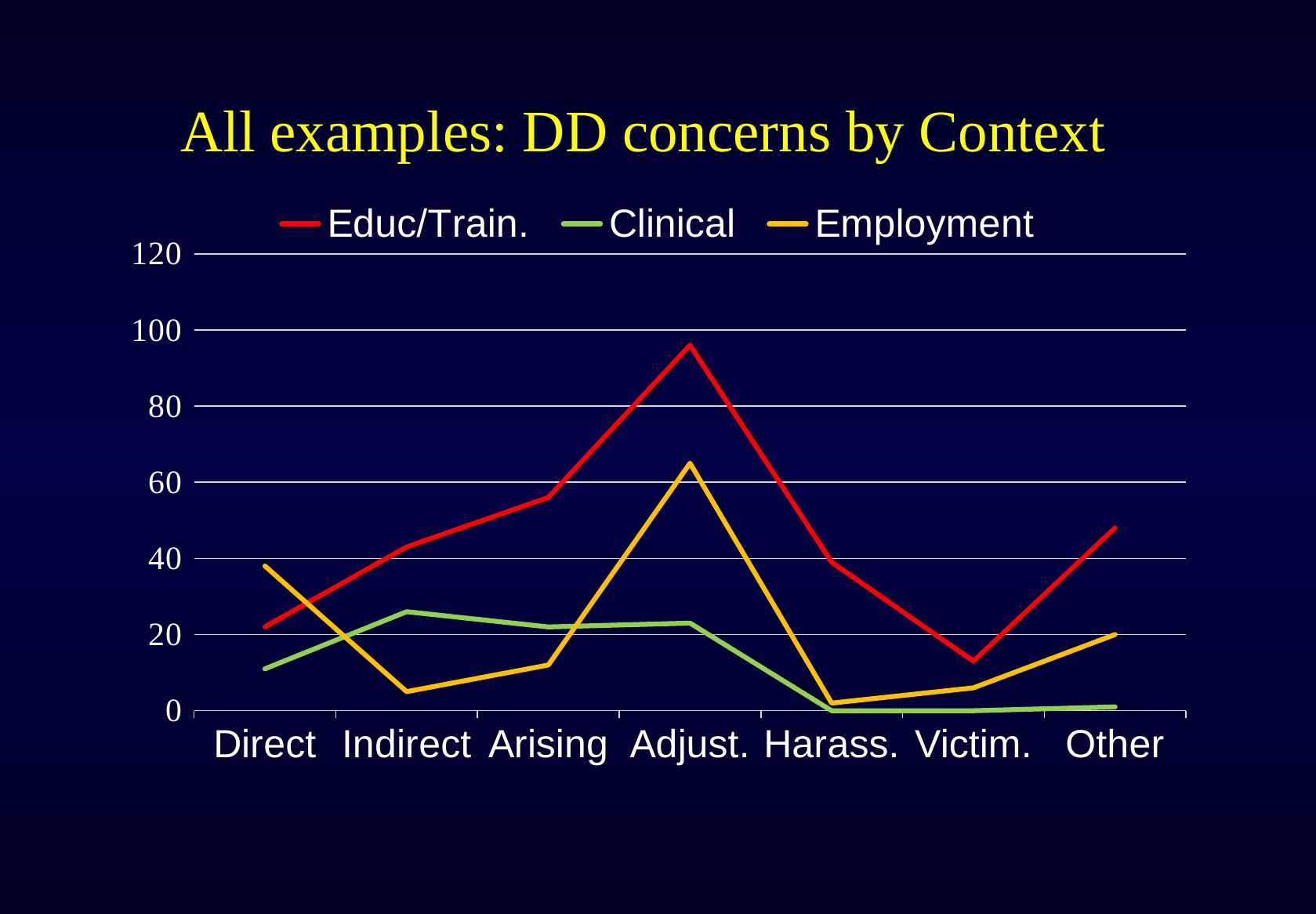
Does the Educ/Train. series rise or fall from Direct to Adjust.? rise How many series does the legend list? 3 Is the Educ/Train. value for Adjust. greater or less than 80? greater For which category is the Educ/Train. series highest? Adjust. For the Other category, which series has the larger value: Educ/Train. or Employment? Educ/Train. For which category is the Employment series highest? Adjust. Is the Clinical value for Indirect greater or less than 20? greater For the Direct category, which series has the larger value: Educ/Train. or Employment? Employment For which category is the Educ/Train. series lowest? Victim. How many categories are shown along the x axis? 7 What kind of chart is shown on the slide? line chart Is the Employment value for Adjust. greater or less than 80? less